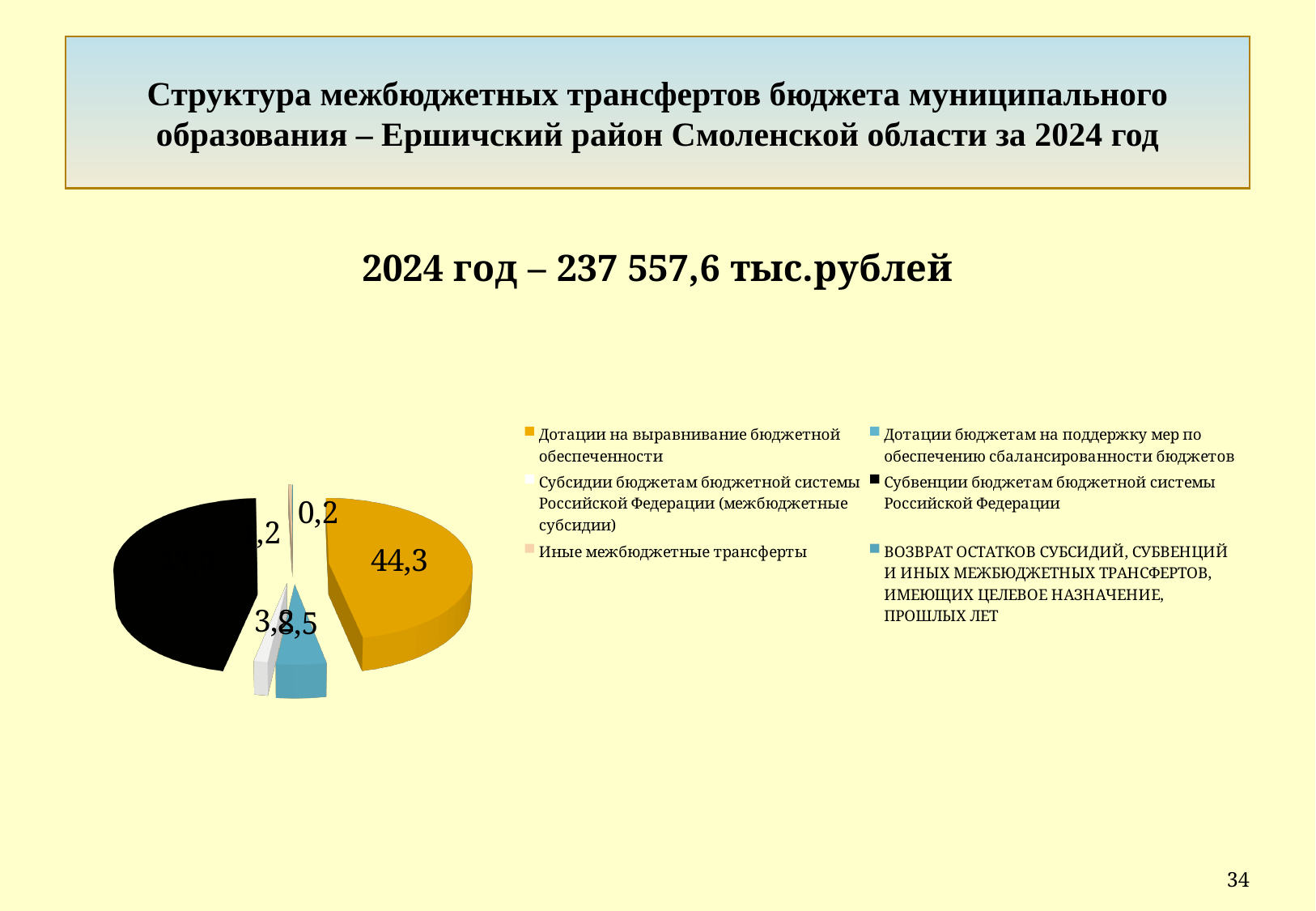
Which is larger: the slice for "Дотации на выравнивание бюджетной обеспеченности" or the slice for "Дотации бюджетам на поддержку мер по обеспечению сбалансированности бюджетов"? Дотации на выравнивание бюджетной обеспеченности What is the value shown for the slice "Иные межбюджетные трансферты"? 0,2 What colour is the slice labelled 44,3? yellow (gold) Which category has the smallest slice in the pie chart? Иные межбюджетные трансферты What kind of chart is shown on the slide? pie chart Which is larger: the slice for "Субвенции бюджетам бюджетной системы Российской Федерации" or the slice for "Иные межбюджетные трансферты"? Субвенции бюджетам бюджетной системы Российской Федерации What is the value shown for the slice "Дотации на выравнивание бюджетной обеспеченности"? 44,3 Which legend entry is shown in black? Субвенции бюджетам бюджетной системы Российской Федерации How many entries does the legend of the pie chart list? 6